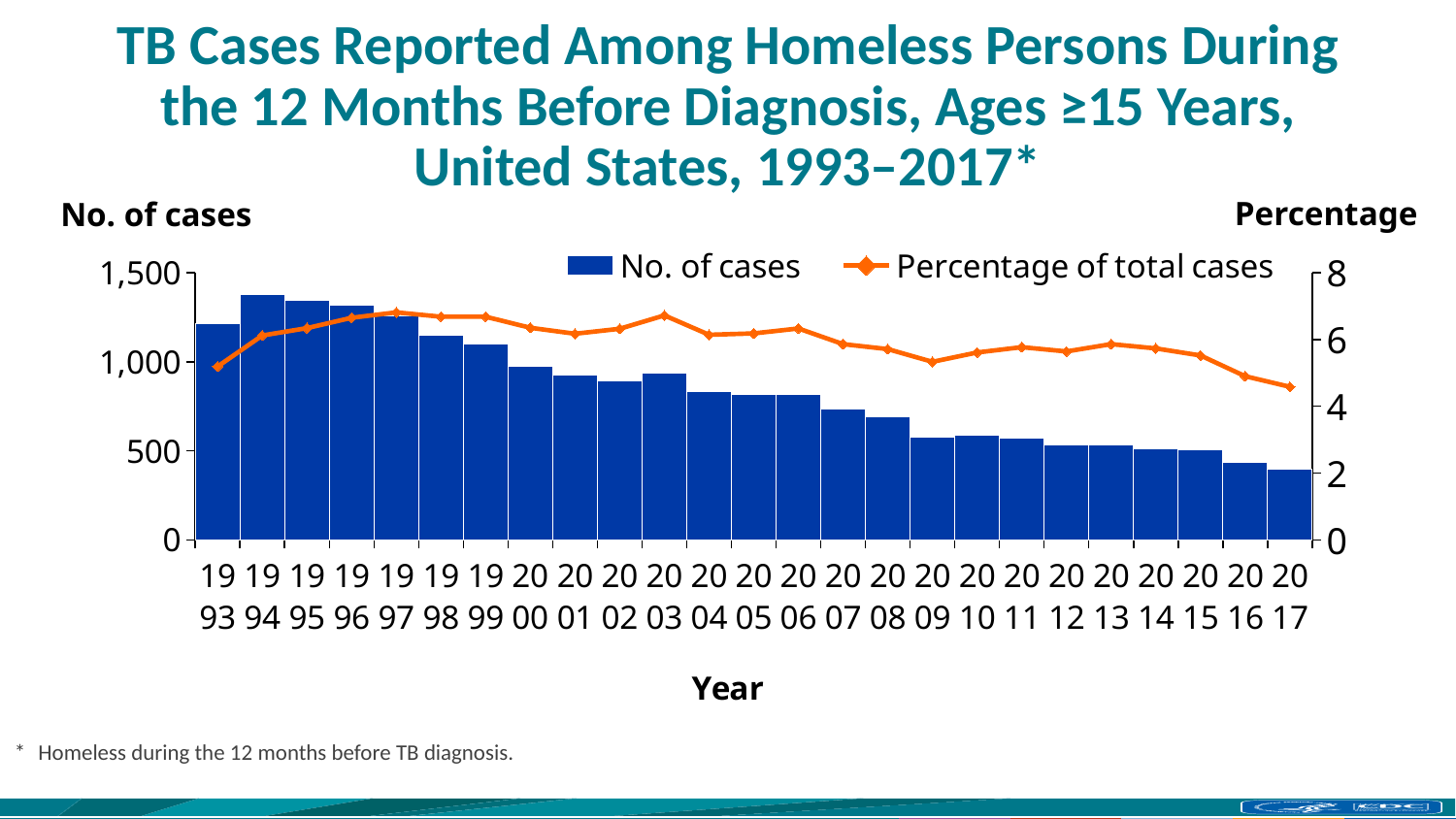
What kind of chart is used to show the number of cases? bar chart Is the number of cases for 1994 greater or less than 1,000? greater Which year has the highest number of cases? 1994 How many series does the legend list? 2 How many years are shown on the x axis? 25 Which year has the lowest number of cases? 2017 Is the number of cases for 2017 greater or less than 500? less Which is larger, the number of cases in 1996 or in 2010? 1996 Is the percentage of total cases for 1997 greater or less than 6? greater Do the number of cases generally rise or fall from 1994 to 2017? fall